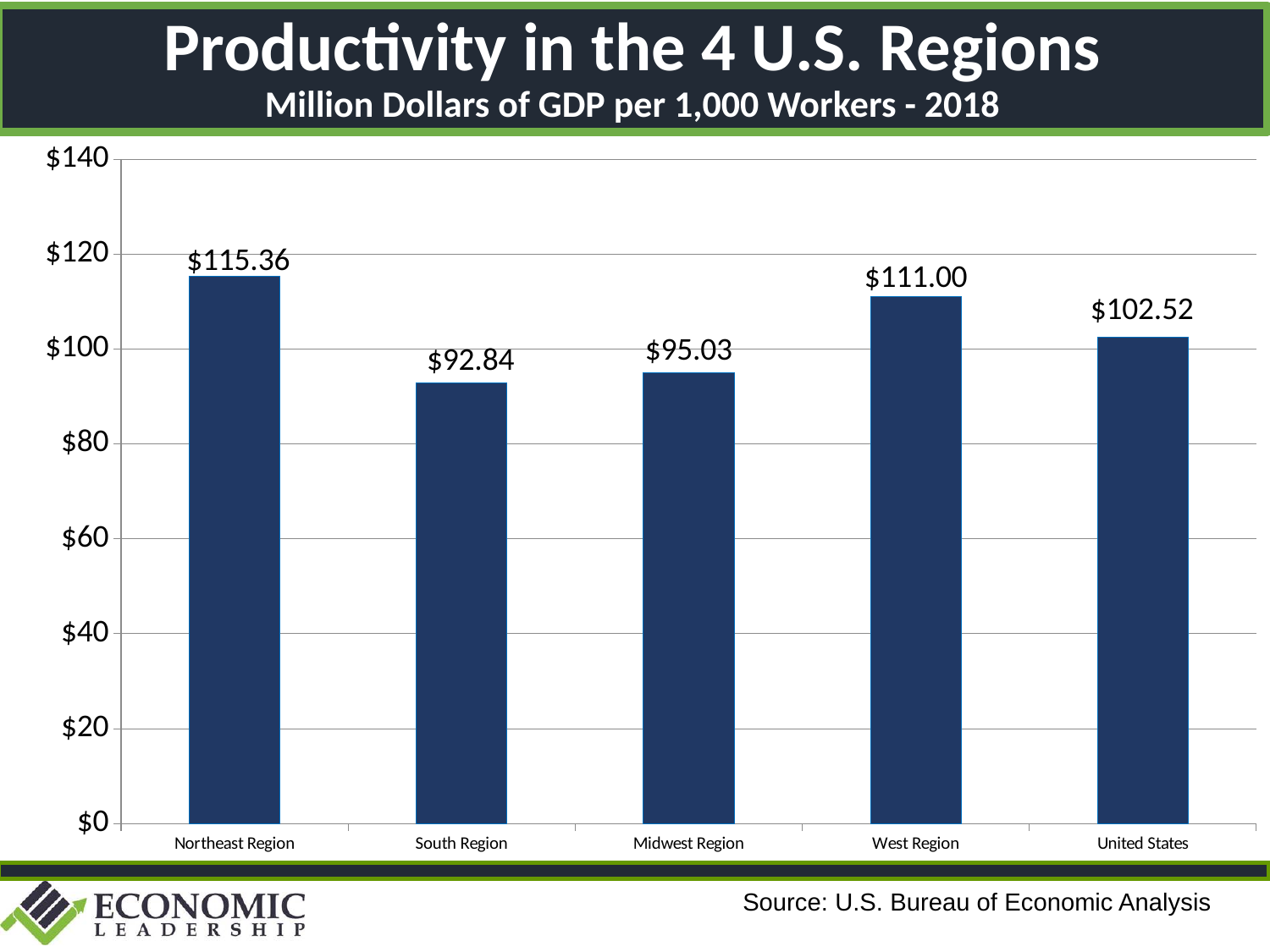
What is the difference between the Northeast Region and the West Region values? $4.36 What kind of chart is shown on the slide? bar chart Which is larger, the value for the West Region or the value for the United States? West Region What is the difference between the Midwest Region and the South Region values? $2.19 Is the value for the Midwest Region greater or less than $100? less How many categories are shown on the x axis? 5 What is the value for the United States? $102.52 What is the value for the Northeast Region? $115.36 Which category has the lowest value? South Region Which category has the highest value? Northeast Region What is the value for the South Region? $92.84 What is the subtitle of the chart? Million Dollars of GDP per 1,000 Workers - 2018